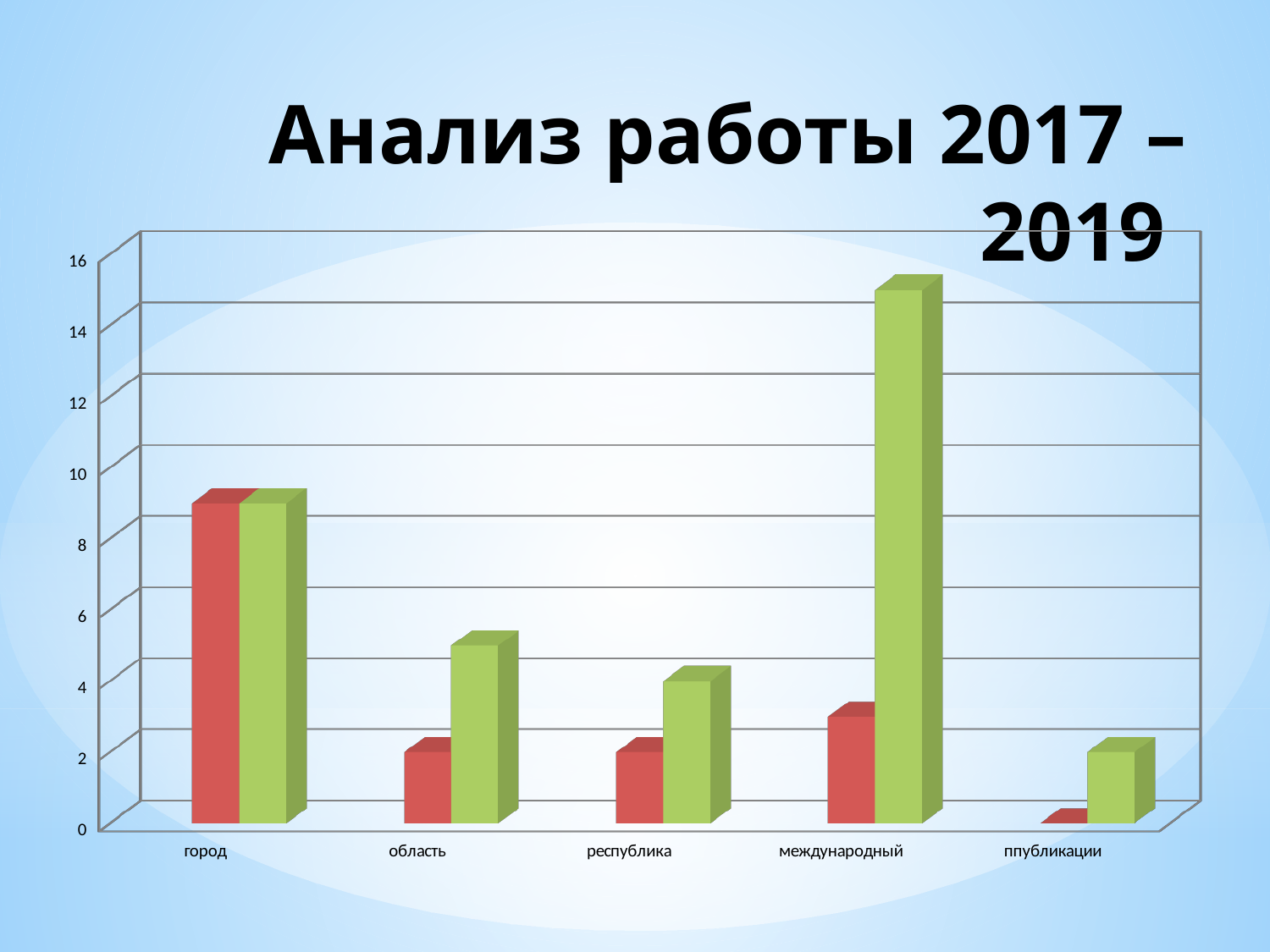
How many categories are shown on the x axis of the chart? 5 Is the green bar for область greater or less than 6? less What is the title of the slide containing the chart? Анализ работы 2017 – 2019 Is the red bar for международный greater or less than 4? less Which category has the tallest green bar? международный For the category область, which bar is taller, the red one or the green one? green Which category has the tallest red bar? город What kind of chart is shown on the slide? bar chart Is the red bar for город greater or less than 8? greater Which category has the shortest green bar? ппубликации For the category международный, which bar is taller, the red one or the green one? green